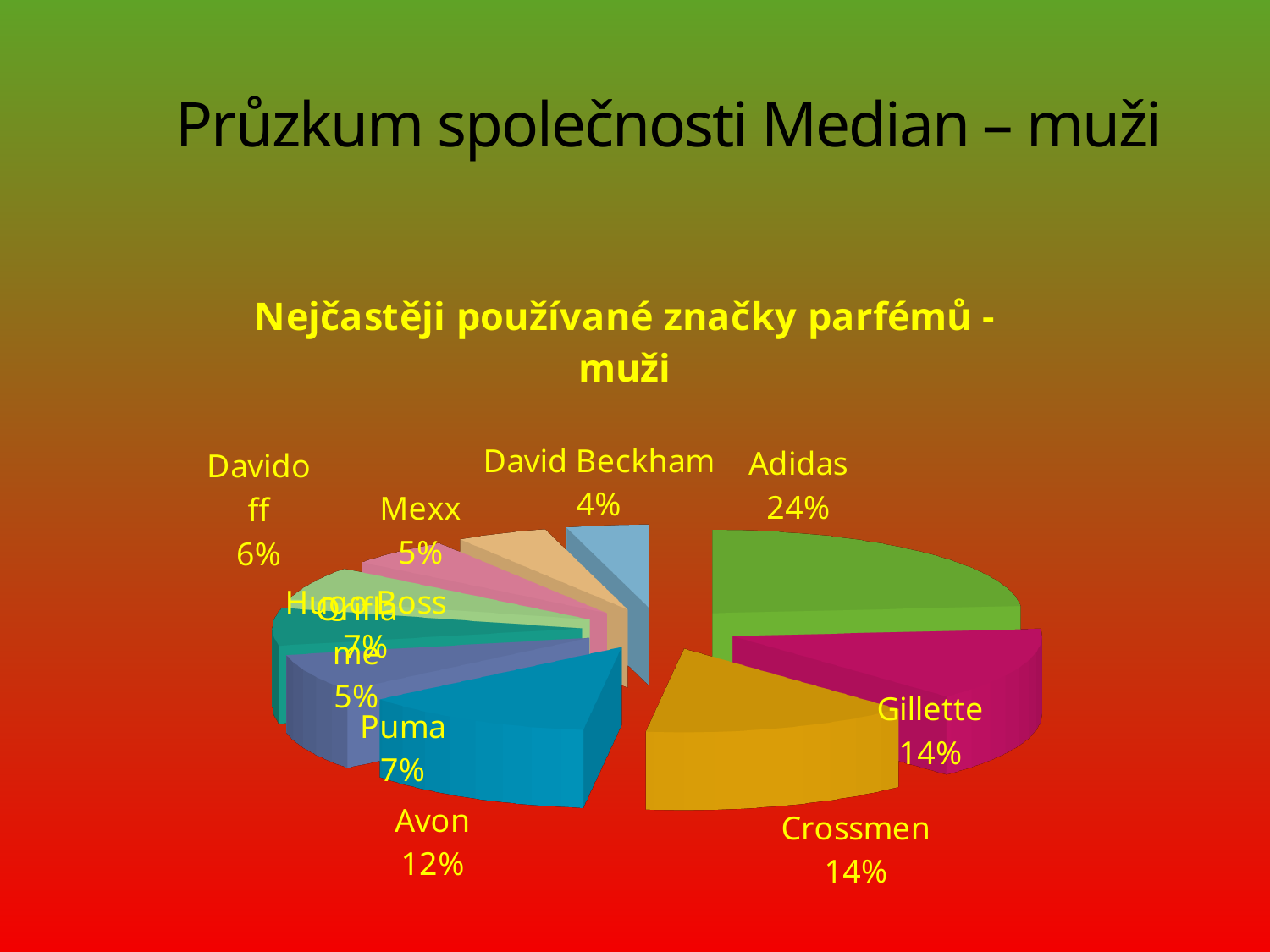
What is the value shown for David Beckham? 4% Which has a larger share, Avon or Puma? Avon What percentage is shown for Puma? 7% What is the difference in percentage points between Adidas and Gillette? 10 percentage points What percentage of the pie does Adidas account for? 24% What type of chart is shown on the slide? Pie chart What percentage is shown for Crossmen? 14% Which brand has the largest slice of the pie? Adidas What is the value shown for Gillette? 14% What is the title of the chart? Nejčastěji používané značky parfémů - muži What percentage is shown for Mexx? 5% What is the value for Avon? 12%